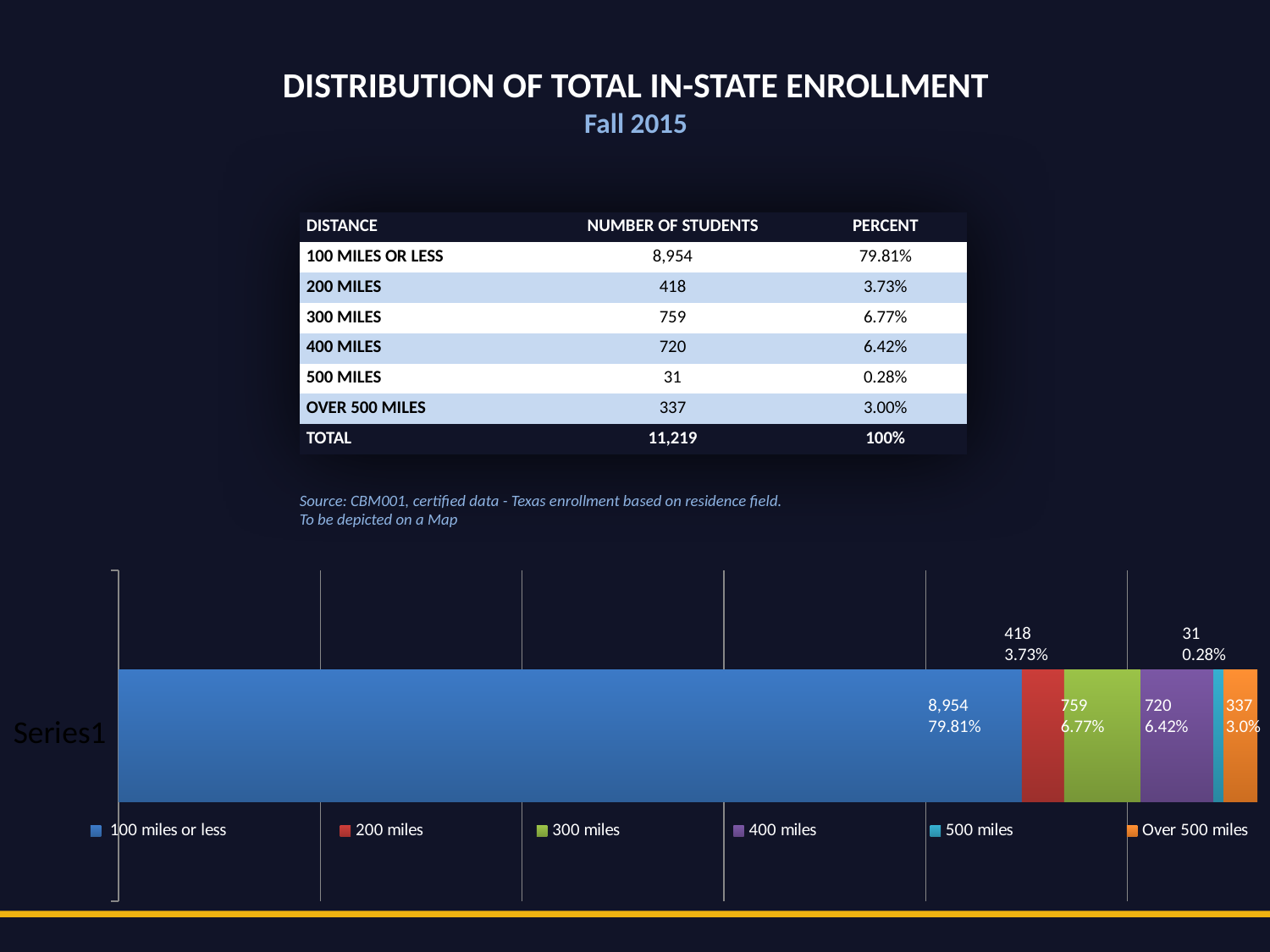
In the bar chart, what is the number of students shown for the 100 miles or less segment? 8,954 In the bar chart, what is the difference between the 200 miles value and the 500 miles value? 387 Which segment of the bar chart has the largest value? 100 miles or less How many segments (categories) does the legend of the bar chart list? 6 In the bar chart, what percentage is shown for the Over 500 miles segment? 3.0% In the bar chart, what percentage is shown for the 300 miles segment? 6.77% What is the name of the single series shown on the bar chart's axis? Series1 Which segment of the bar chart has the smallest value? 500 miles In the bar chart, what value is shown for the 500 miles segment? 31 What is the total of all segments in the stacked bar? 11,219 What kind of chart is shown at the bottom of the slide? Stacked bar chart In the bar chart, which is larger: the 300 miles segment or the 400 miles segment? 300 miles